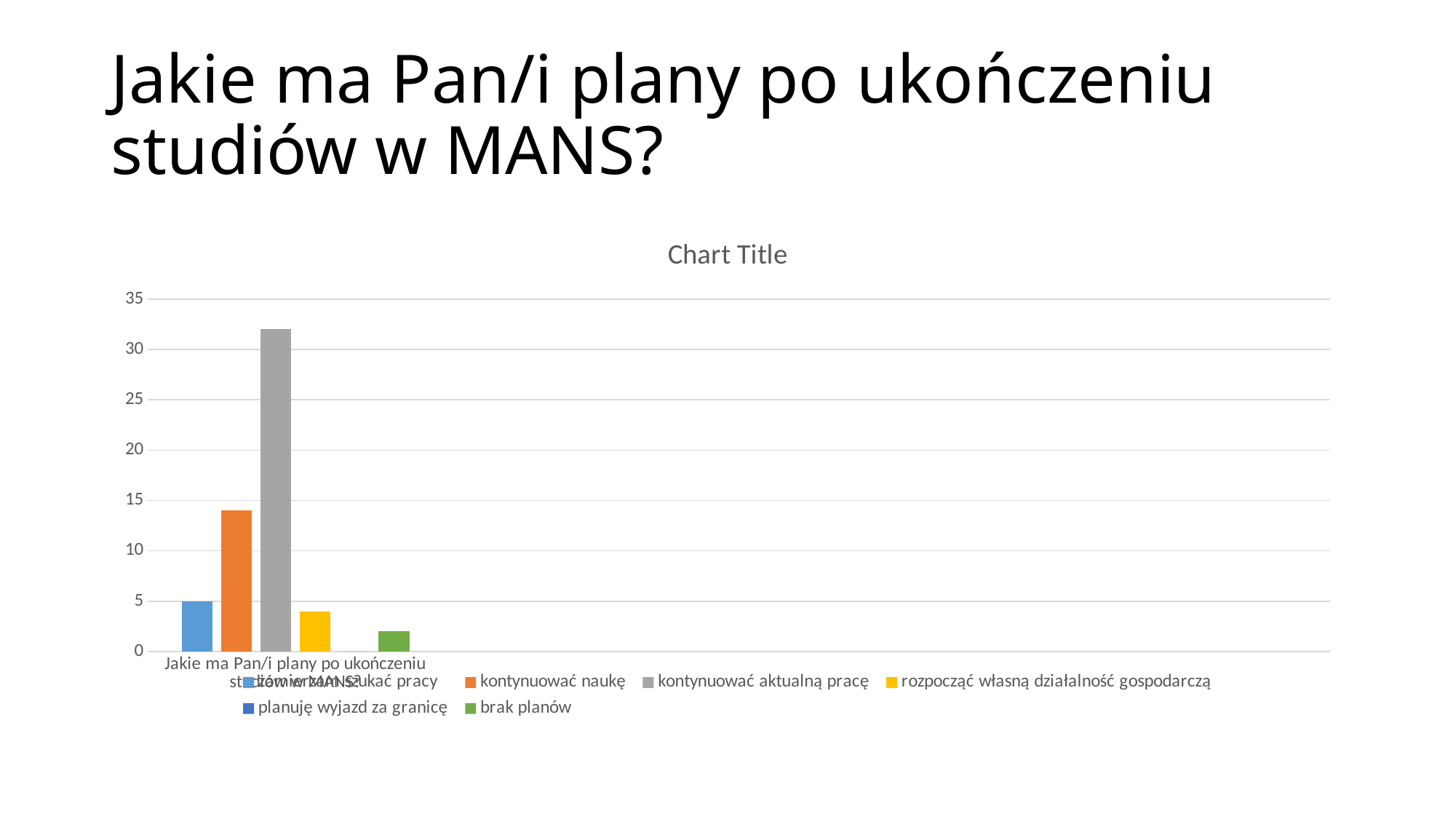
Which is larger, the value for kontynuować naukę or the value for brak planów? kontynuować naukę Is the value for kontynuować naukę greater or less than 10? greater How many series does the legend list? 6 What kind of chart is shown on the slide? bar chart Which series has the tallest bar? kontynuować aktualną pracę Is the value for brak planów greater or less than 5? less Which is larger, the value for rozpocząć własną działalność gospodarczą or the value for brak planów? rozpocząć własną działalność gospodarczą What is the title shown above the chart? Chart Title Is the value for rozpocząć własną działalność gospodarczą greater or less than 5? less What colour is the bar for kontynuować aktualną pracę? gray